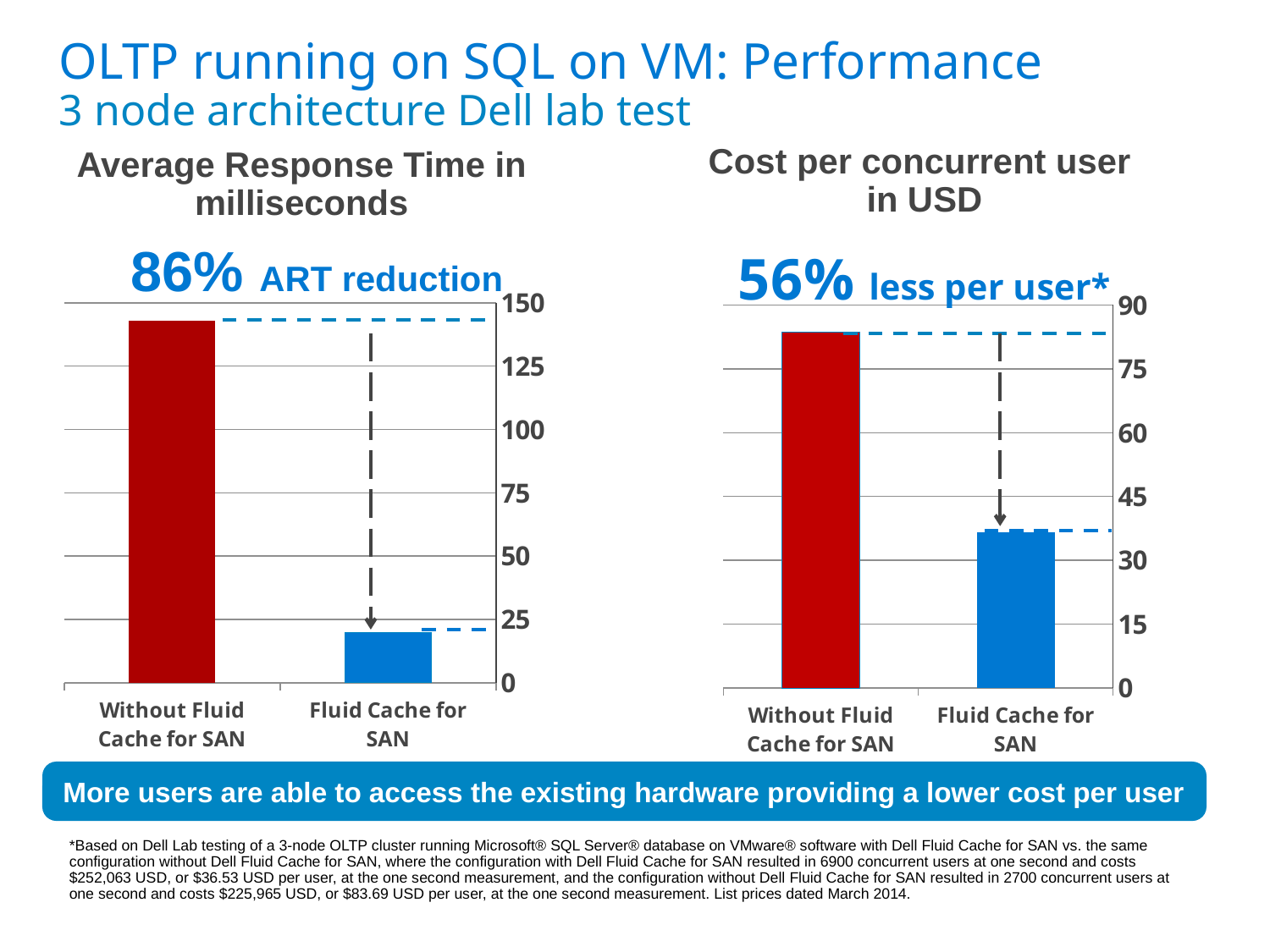
In the 'Average Response Time in milliseconds' chart, is the value for Without Fluid Cache for SAN greater or less than 125? greater What percentage reduction is annotated above the 'Average Response Time in milliseconds' chart? 86% In the 'Average Response Time in milliseconds' chart, is the value for Fluid Cache for SAN greater or less than 25? less In the 'Cost per concurrent user in USD' chart, is the value for Fluid Cache for SAN greater or less than 30? greater How many categories are shown in the 'Average Response Time in milliseconds' chart? 2 In the 'Average Response Time in milliseconds' chart, do the values rise or fall from left to right? fall What kind of chart is the 'Average Response Time in milliseconds' chart? bar chart In the 'Cost per concurrent user in USD' chart, which category has the lowest value? Fluid Cache for SAN In the 'Cost per concurrent user in USD' chart, which is larger: Without Fluid Cache for SAN or Fluid Cache for SAN? Without Fluid Cache for SAN What percentage is annotated above the 'Cost per concurrent user in USD' chart? 56% In the 'Average Response Time in milliseconds' chart, which category has the highest value? Without Fluid Cache for SAN